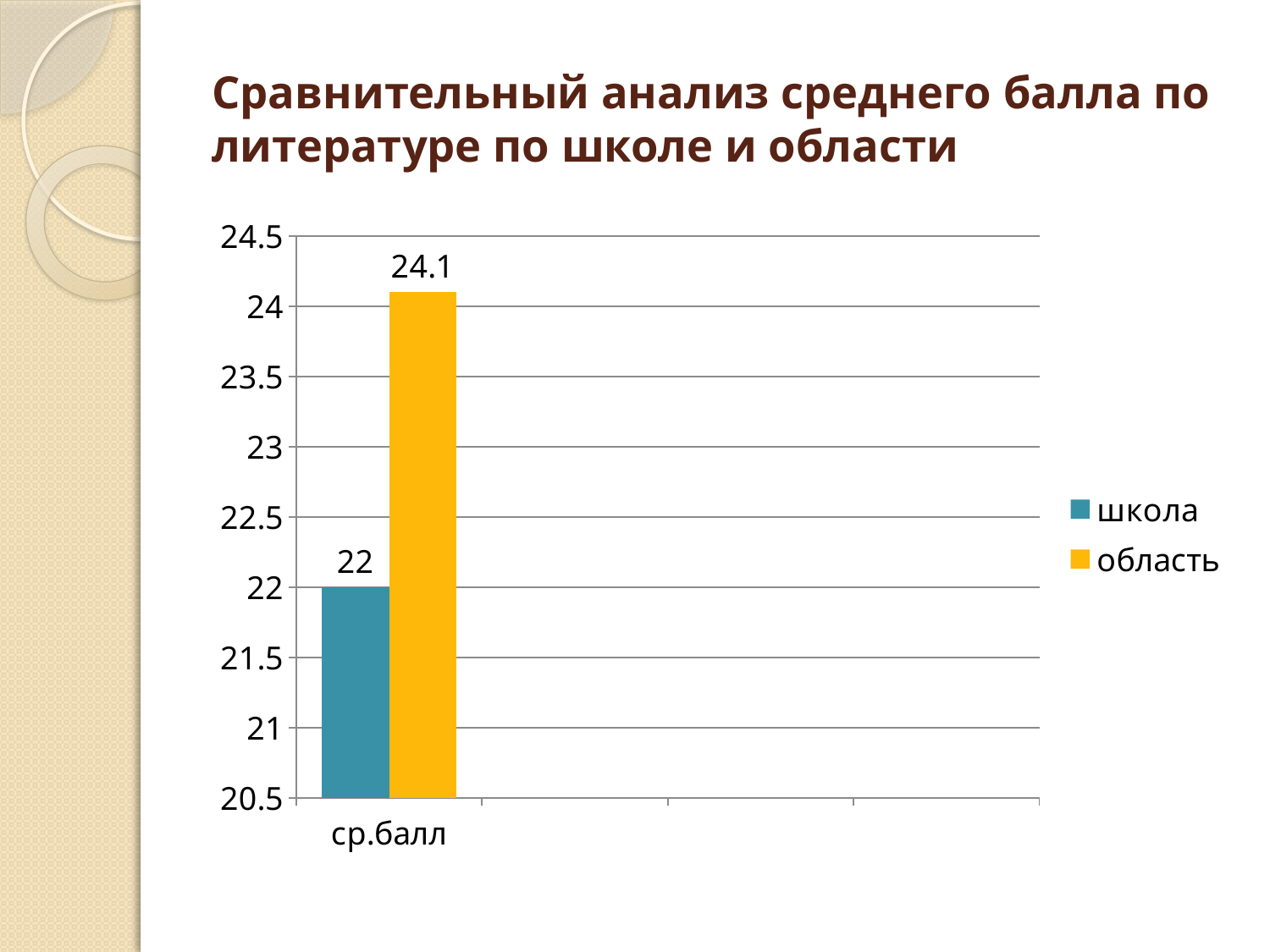
What is the value for школа? 22 What is the value for область? 24.1 Which series has the lowest value? школа What is the difference between the values for область and школа? 2.1 Which series has the higher value, школа or область? область Is the value for школа greater or less than 23? less Is the value for область greater or less than 24? greater What colour is the bar for область? yellow What is the label of the category on the x axis? ср.балл How many series does the legend list? 2 What kind of chart is shown on the slide? bar chart How many categories are shown on the x axis? 1